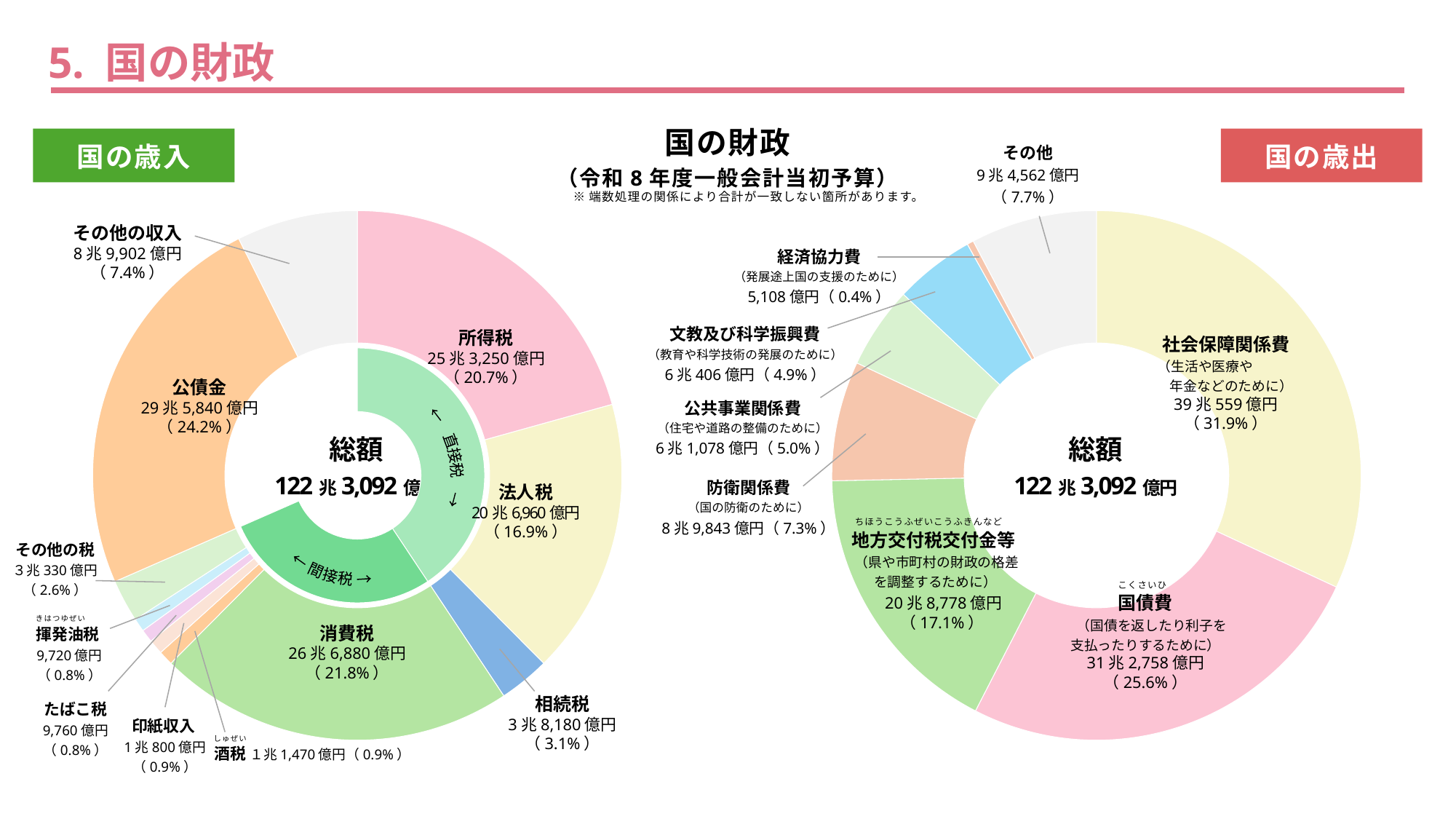
「国の歳入」のグラフで、最も割合が大きい項目はどれですか？ 公債金 「国の歳出」のグラフで、防衛関係費の金額はいくらですか？ 8兆9,843億円 「国の歳入」のグラフで、消費税と法人税では、どちらの割合が大きいですか？ 消費税 「国の歳入」のグラフで、相続税の割合は何％ですか？ 3.1% 「国の歳入」のグラフの総額はいくらですか？ 122兆3,092億円 「国の歳入」のグラフの内側の輪は、税を何と何に分けていますか？ 直接税と間接税 「国の歳出」のグラフで、国債費と地方交付税交付金等の割合の差は何ポイントですか？ 8.5ポイント 「国の歳入」のグラフで、所得税の金額はいくらですか？ 25兆3,250億円 「国の歳出」のグラフには、いくつの項目がありますか？ 8 「国の歳出」のグラフで、最も金額が小さい項目はどれですか？ 経済協力費 このスライドのグラフはどの種類のグラフですか？ 円グラフ（ドーナツグラフ） 「国の歳出」のグラフで、社会保障関係費の割合は何％ですか？ 31.9%